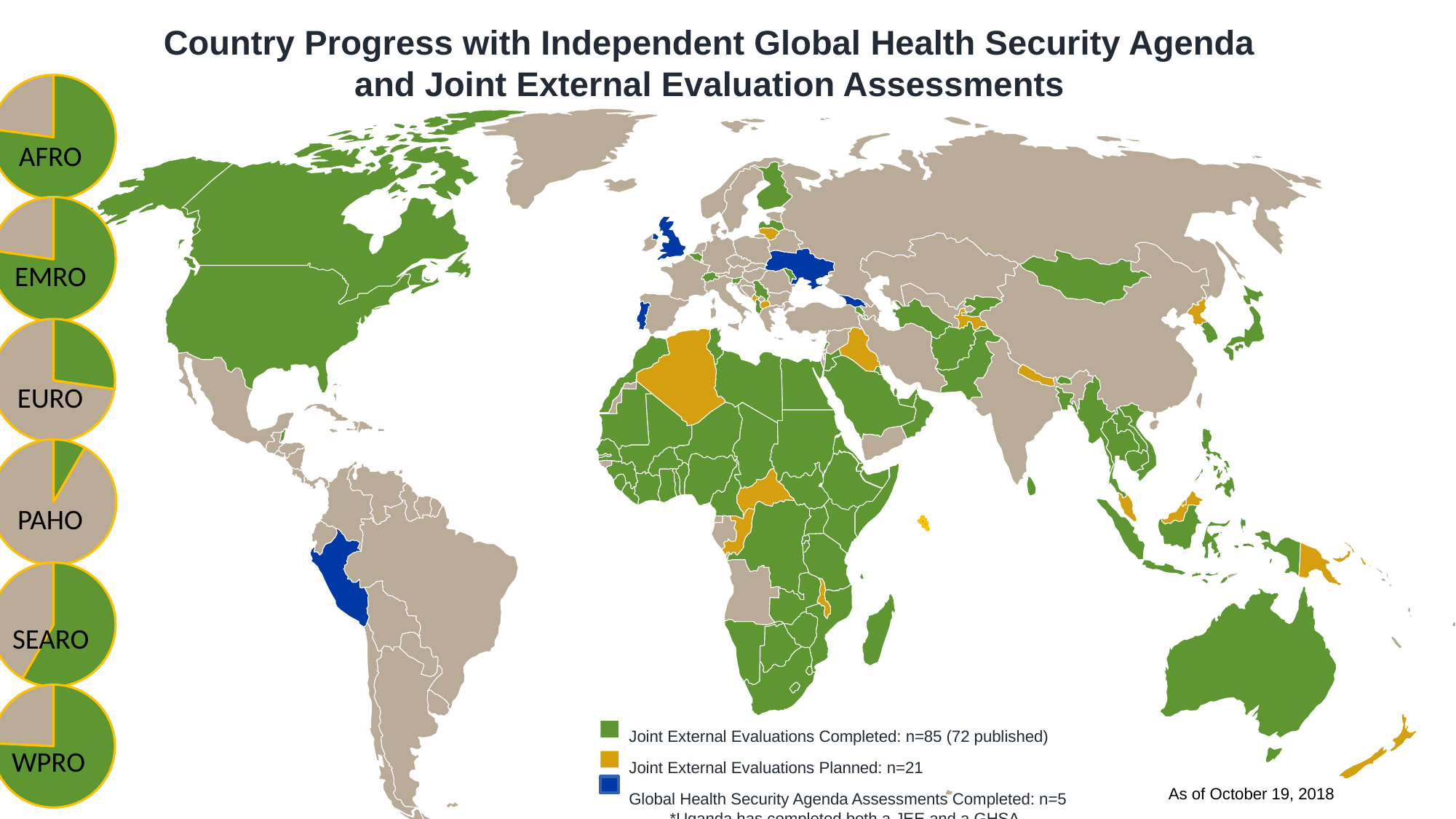
In the PAHO pie chart, is the green slice larger or smaller than the grey slice? Smaller Which has a larger green share of its pie chart, EURO or PAHO? EURO Which region's pie chart has the smallest green slice? PAHO What colour on the map represents countries with Joint External Evaluations planned? Yellow/orange How many regional pie charts are shown on the left side of the slide? 6 According to the map legend, how many countries have Joint External Evaluations planned? n=21 In the AFRO pie chart, is the green slice larger or smaller than the grey slice? Larger According to the map legend, how many countries have completed Global Health Security Agenda Assessments? n=5 According to the map legend, how many countries have completed Joint External Evaluations? n=85 (72 published) As of what date is the data on the slide reported? October 19, 2018 What kind of charts are shown down the left side of the slide for the WHO regions? Pie charts